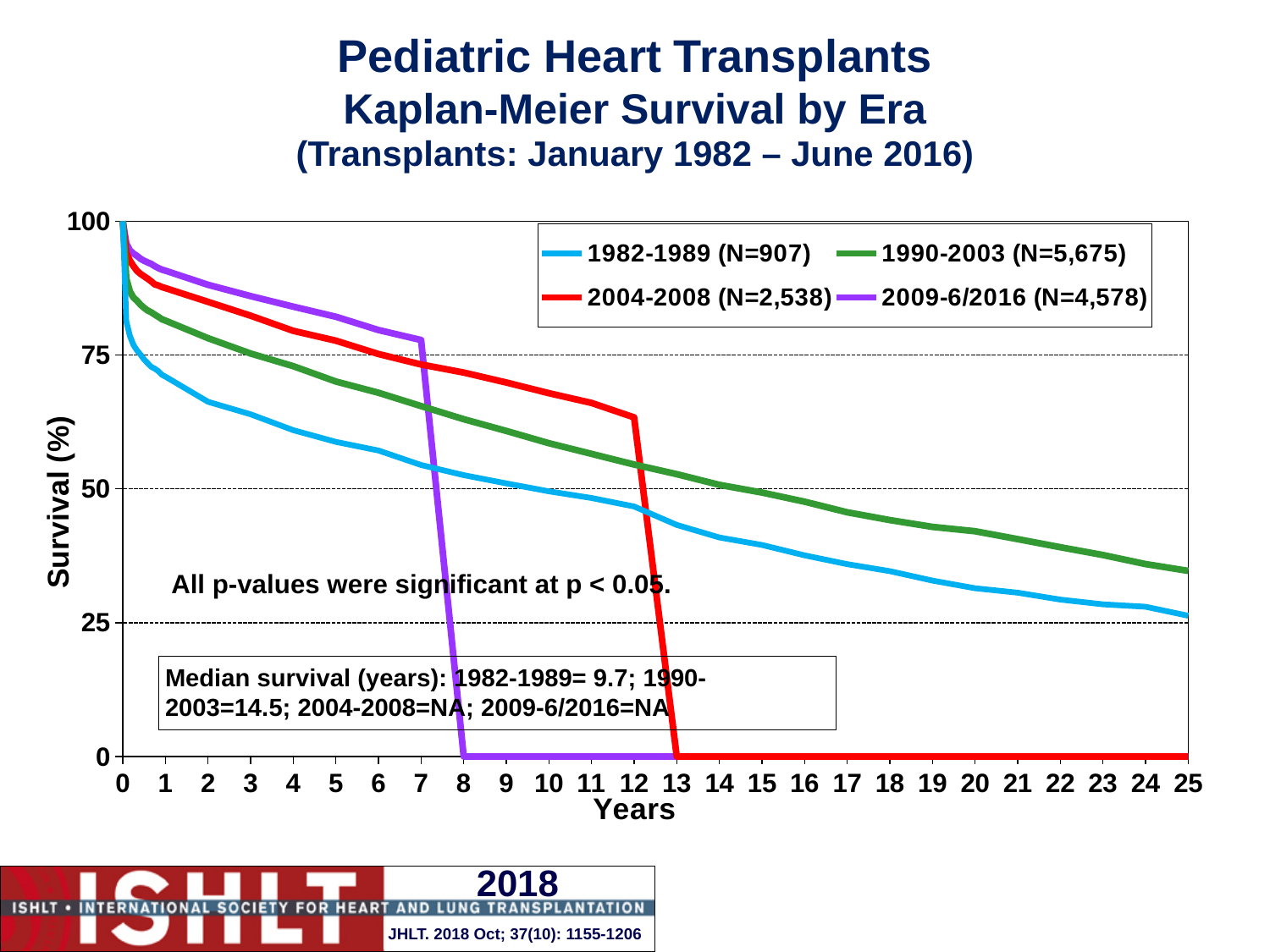
At year 5, which era has higher survival: 1982-1989 or 2009-6/2016? 2009-6/2016 Is the survival for 2004-2008 at year 5 greater or less than 75? greater Is the survival for 1982-1989 at year 15 greater or less than 50? less According to the legend, what is the N for the 1990-2003 era? 5,675 Is the survival for 1990-2003 at year 20 greater or less than 50? less What is the median survival in years for the 1982-1989 era, as stated on the slide? 9.7 At year 20, which era has higher survival: 1982-1989 or 1990-2003? 1990-2003 How many series does the legend list? 4 Which era has the highest survival at year 5? 2009-6/2016 What kind of chart is shown on the slide? Line chart Do the survival curves rise or fall as the years increase along the x axis? Fall